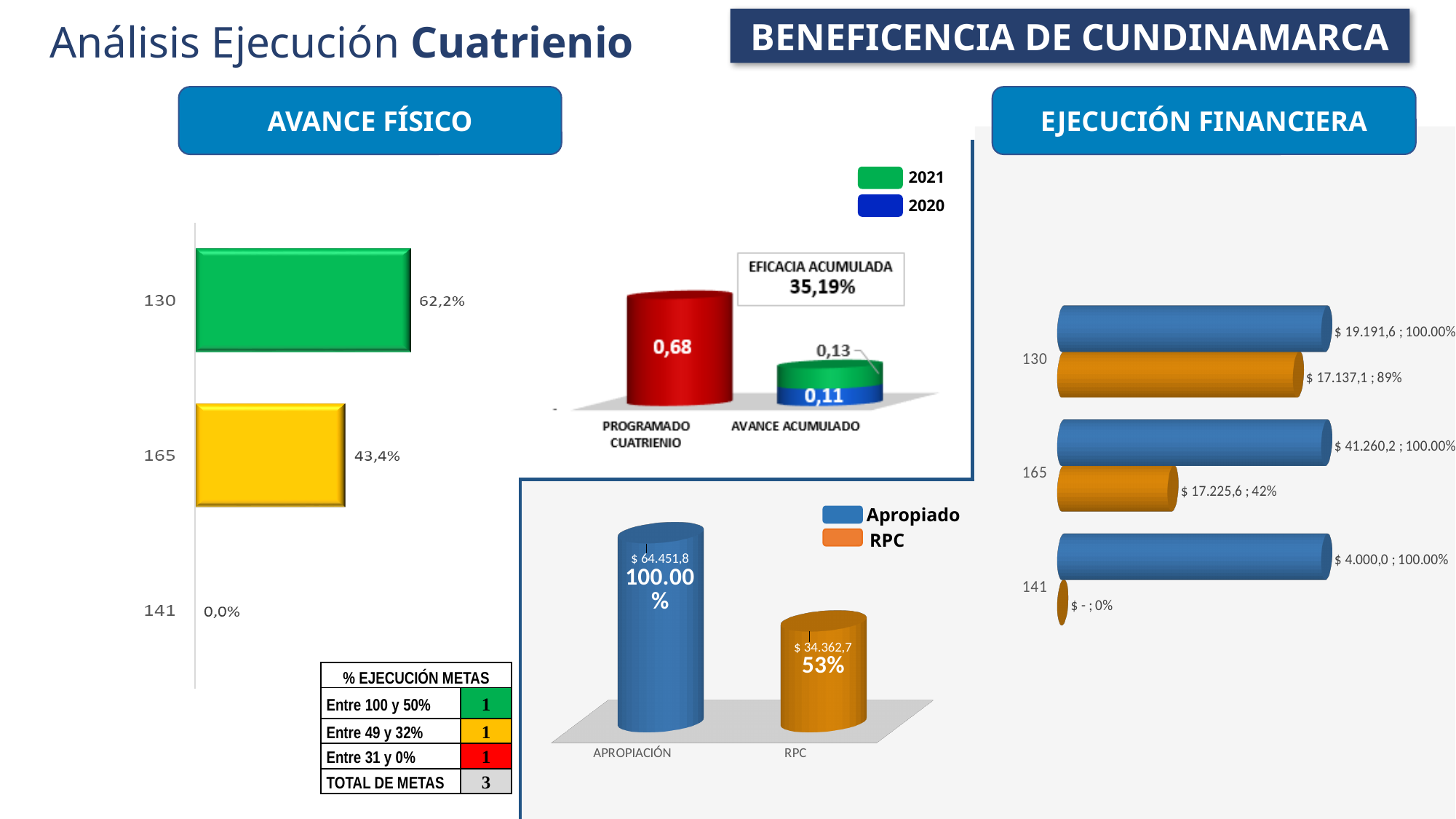
In the chart in the top middle, what is the 2021 value for Avance Acumulado? 0,13 In the Ejecución Financiera chart on the right, how many series does the legend list? 2 In the chart in the bottom middle, what is the value for RPC? $ 34.362,7 In the chart in the top middle, what is the Eficacia Acumulada shown? 35,19% In the Ejecución Financiera chart on the right, what is the RPC value for category 165? $ 17.225,6 ; 42% In the Avance Físico bar chart on the left, how many categories are shown? 3 In the chart in the bottom middle, what percentage is shown for Apropiación? 100.00% In the Avance Físico bar chart on the left, which category has the lowest value? 141 In the Avance Físico bar chart on the left, what is the value for category 165? 43,4% In the Avance Físico bar chart on the left, what is the difference between the values for 130 and 165? 18,8% In the chart in the top middle, what is the value for Programado Cuatrienio? 0,68 In the Avance Físico bar chart on the left, what is the value for category 130? 62,2%